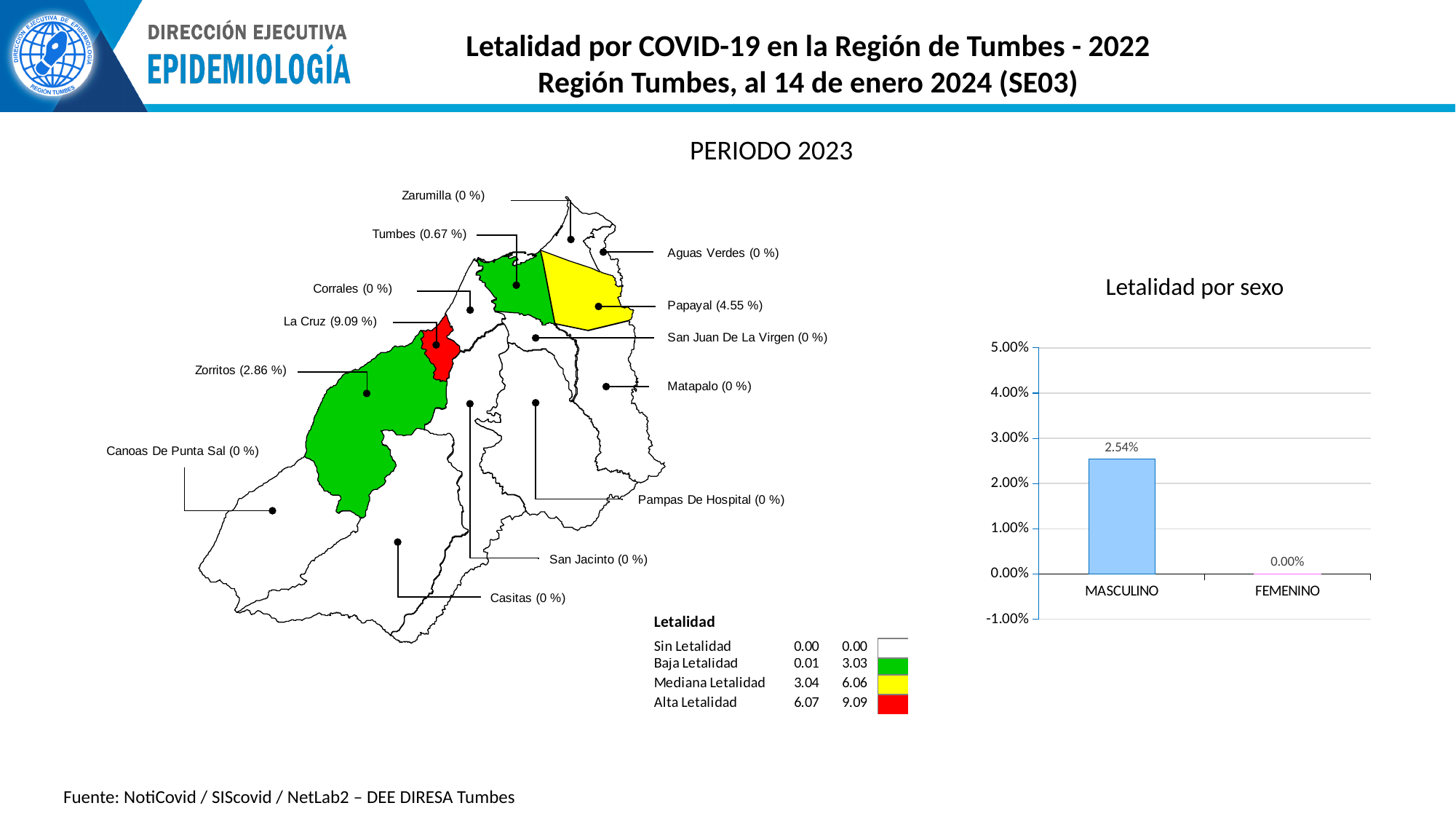
On the map for PERIODO 2023, what is the lethality value shown for La Cruz? 9.09 % In the 'Letalidad por sexo' chart, what is the difference between the MASCULINO and FEMENINO values? 2.54% In the 'Letalidad por sexo' chart, what is the value for FEMENINO? 0.00% How many categories are shown in the 'Letalidad por sexo' chart? 2 What kind of chart is 'Letalidad por sexo'? bar chart In the 'Letalidad por sexo' chart, is the value for MASCULINO greater or less than 3.00%? less In the 'Letalidad por sexo' chart, what is the value for MASCULINO? 2.54% What is the title of the chart on the right side of the slide? Letalidad por sexo On the map for PERIODO 2023, what is the lethality value shown for Papayal? 4.55 % In the 'Letalidad por sexo' chart, which category has the lowest value? FEMENINO In the 'Letalidad por sexo' chart, which category has the highest value? MASCULINO On the map for PERIODO 2023, which district has the highest lethality value? La Cruz